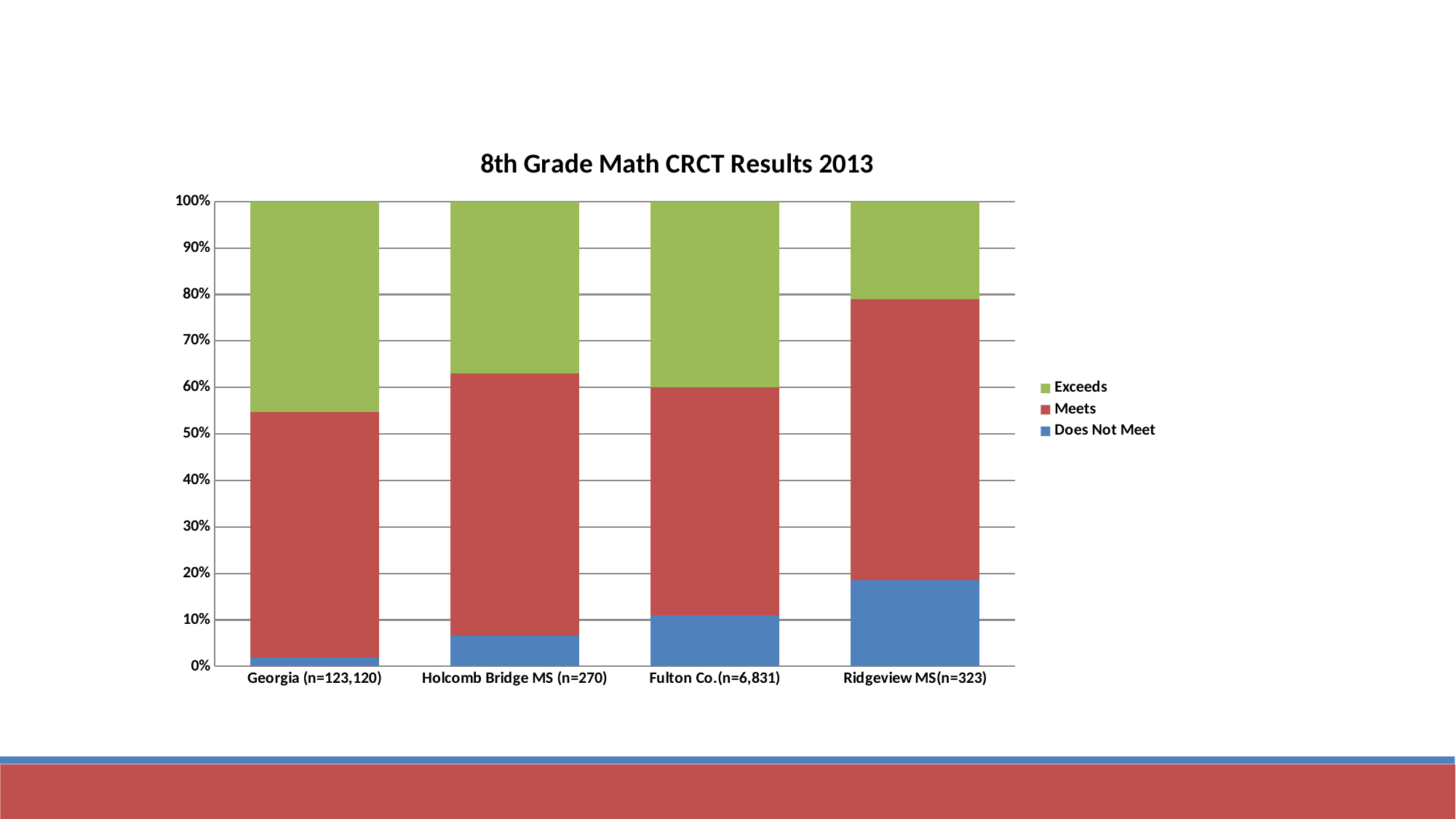
Which category has the largest Does Not Meet share? Ridgeview MS(n=323) What kind of chart is shown on the slide? Stacked bar chart Is the Does Not Meet value for Holcomb Bridge MS (n=270) greater or less than 10%? less Which category has the smallest Does Not Meet share? Georgia (n=123,120) How many categories are shown along the x axis? 4 Which category has the largest Exceeds share? Georgia (n=123,120) Is the Does Not Meet value for Ridgeview MS(n=323) greater or less than 10%? greater Which category has the smallest Exceeds share? Ridgeview MS(n=323) Does the Does Not Meet share rise or fall moving from left to right across the categories? Rises What is the title of the chart? 8th Grade Math CRCT Results 2013 How many series does the legend list? 3 Which series is shown in blue in the legend? Does Not Meet